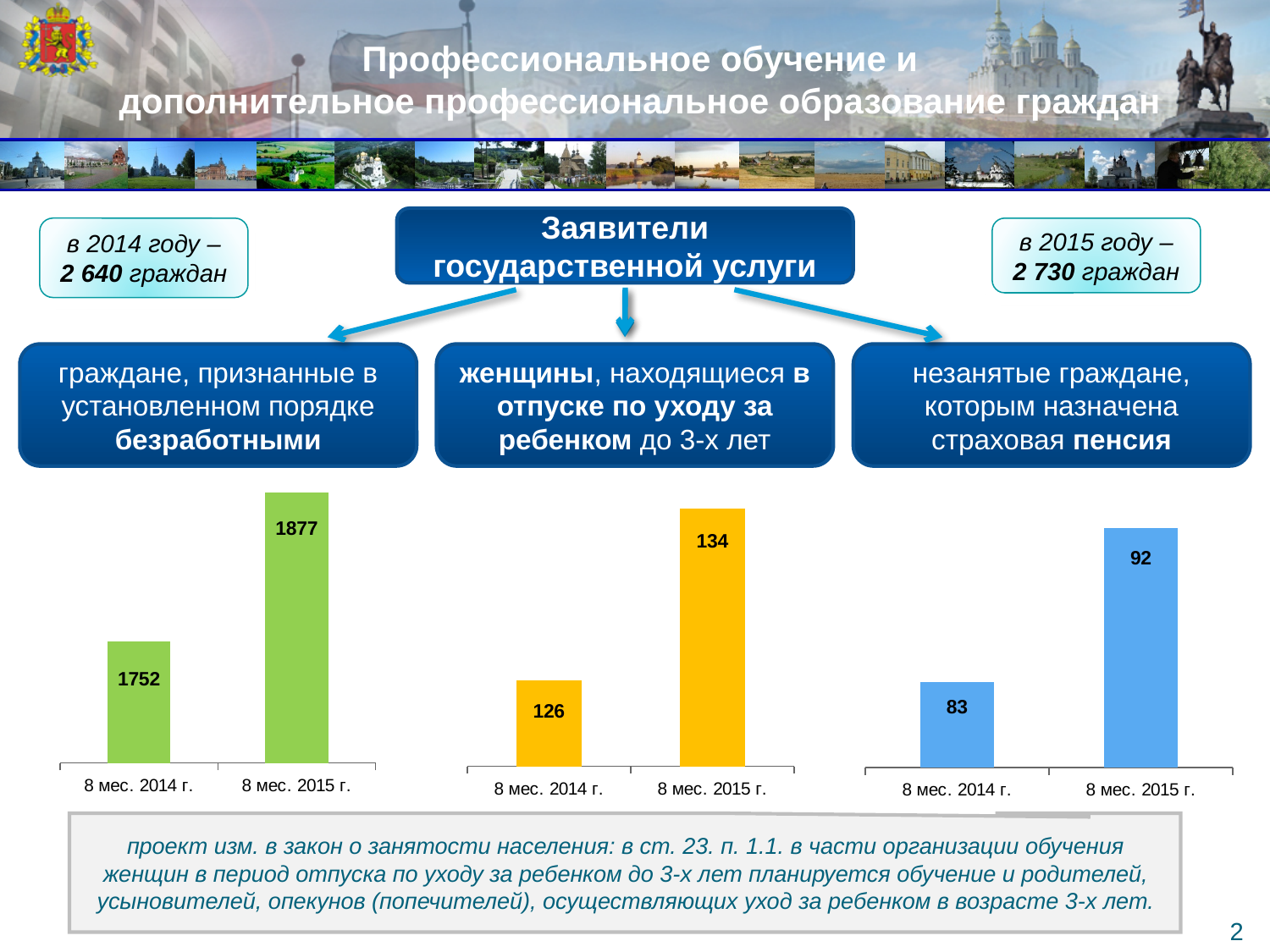
In the left chart, what is the value for 8 мес. 2015 г.? 1877 In the right chart, what is the difference between the values for 8 мес. 2015 г. and 8 мес. 2014 г.? 9 In the left chart, do the values rise or fall from 8 мес. 2014 г. to 8 мес. 2015 г.? rise In the middle chart, what is the difference between the values for 8 мес. 2015 г. and 8 мес. 2014 г.? 8 In the right chart, what is the value for 8 мес. 2014 г.? 83 In the right chart, which period has the higher value, 8 мес. 2014 г. or 8 мес. 2015 г.? 8 мес. 2015 г. In the left chart, what is the value for 8 мес. 2014 г.? 1752 In the left chart, what is the difference between the values for 8 мес. 2015 г. and 8 мес. 2014 г.? 125 What type of chart is the middle chart? bar chart In the middle chart, which period has the lowest value? 8 мес. 2014 г. In the middle chart, what is the value for 8 мес. 2015 г.? 134 How many bars does the left chart have? 2